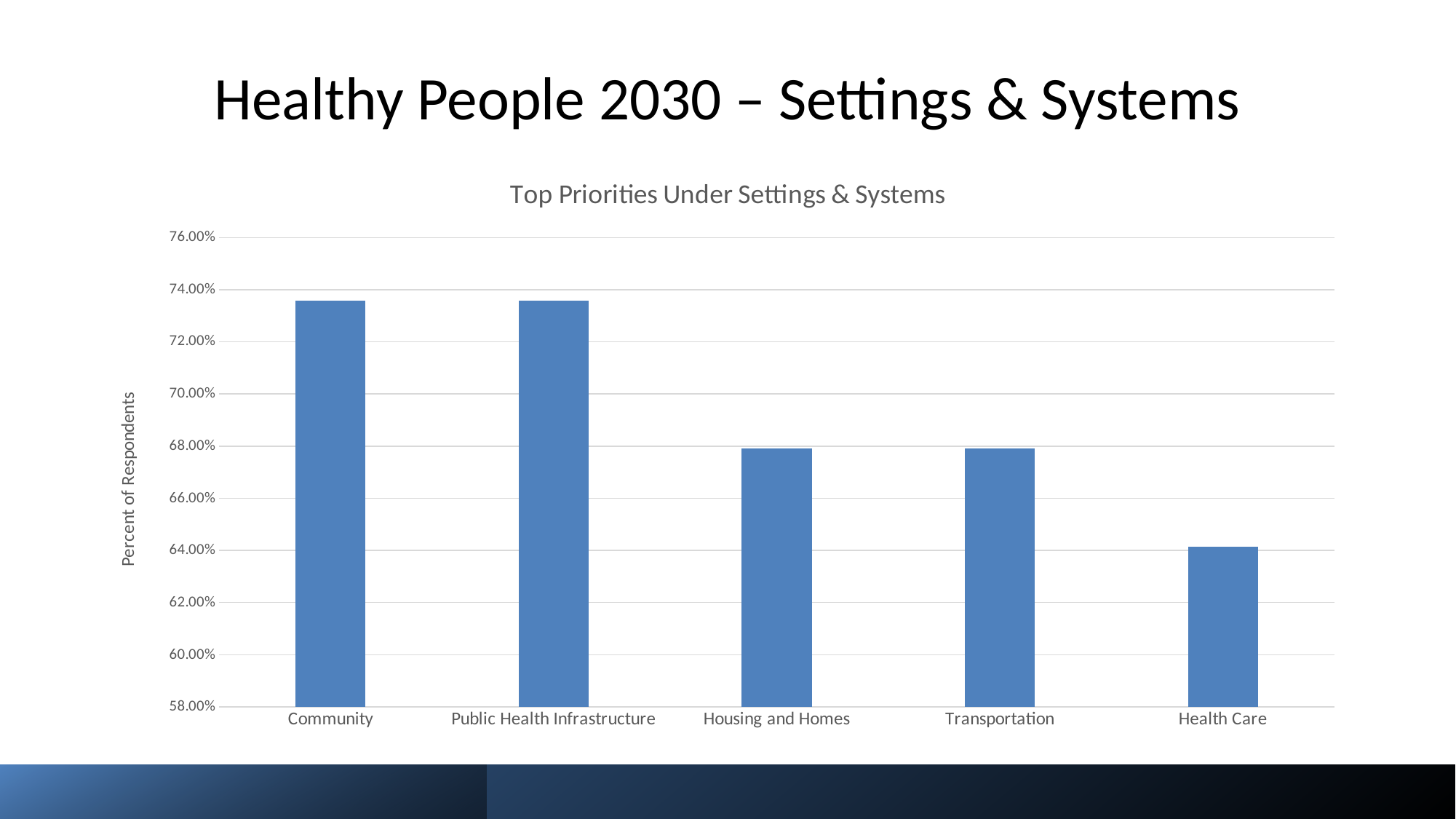
How many categories are shown on the x axis of the chart? 5 Which is larger, the value for Housing and Homes or the value for Health Care? Housing and Homes Which category has the lowest value in the chart? Health Care What is the title of the chart? Top Priorities Under Settings & Systems Do the values generally rise or fall from left to right across the categories? fall Which is larger, the value for Community or the value for Health Care? Community Is the value for Public Health Infrastructure greater or less than 74.00%? less Is the value for Transportation greater or less than 66.00%? greater What kind of chart is shown on the slide? bar chart Is the value for Health Care greater or less than 66.00%? less